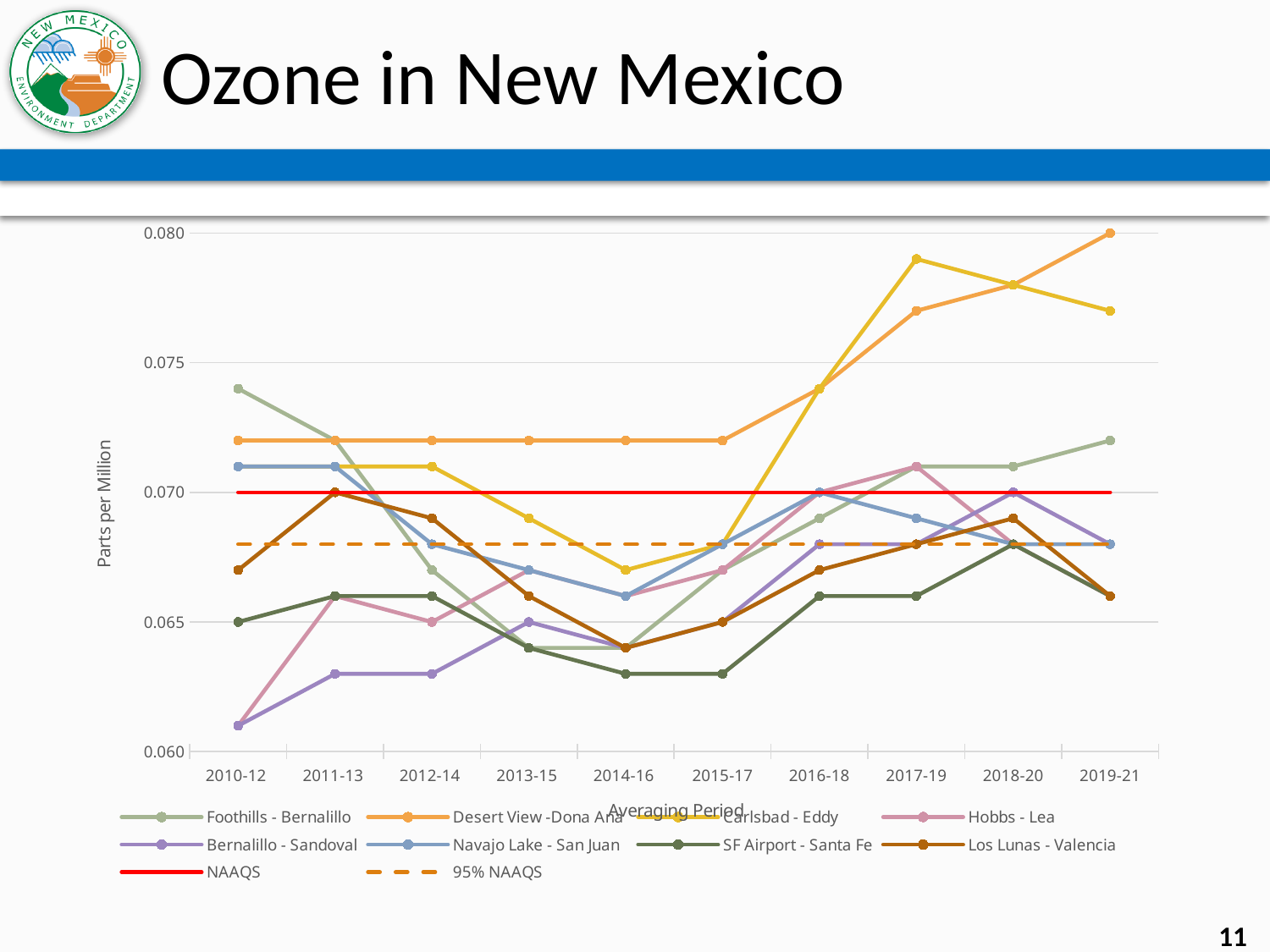
In 2017-19, which is higher: Carlsbad - Eddy or Desert View -Dona Ana? Carlsbad - Eddy How many entries does the legend list? 10 Is the value for Bernalillo - Sandoval in 2010-12 greater or less than 0.065? less What is the label of the y axis? Parts per Million Which site has the highest value in the 2019-21 averaging period? Desert View -Dona Ana What kind of chart is shown on the slide? line chart Is the value for Foothills - Bernalillo in 2010-12 greater or less than 0.070? greater What is the value of the NAAQS line in parts per million? 0.070 How many averaging periods are shown on the x axis? 10 Which site has the lowest value in the 2010-12 averaging period? Bernalillo - Sandoval and Hobbs - Lea (tied at 0.061) Does the Desert View -Dona Ana line rise or fall from 2015-17 to 2019-21? rise Is the value for Carlsbad - Eddy in 2017-19 greater or less than 0.075? greater